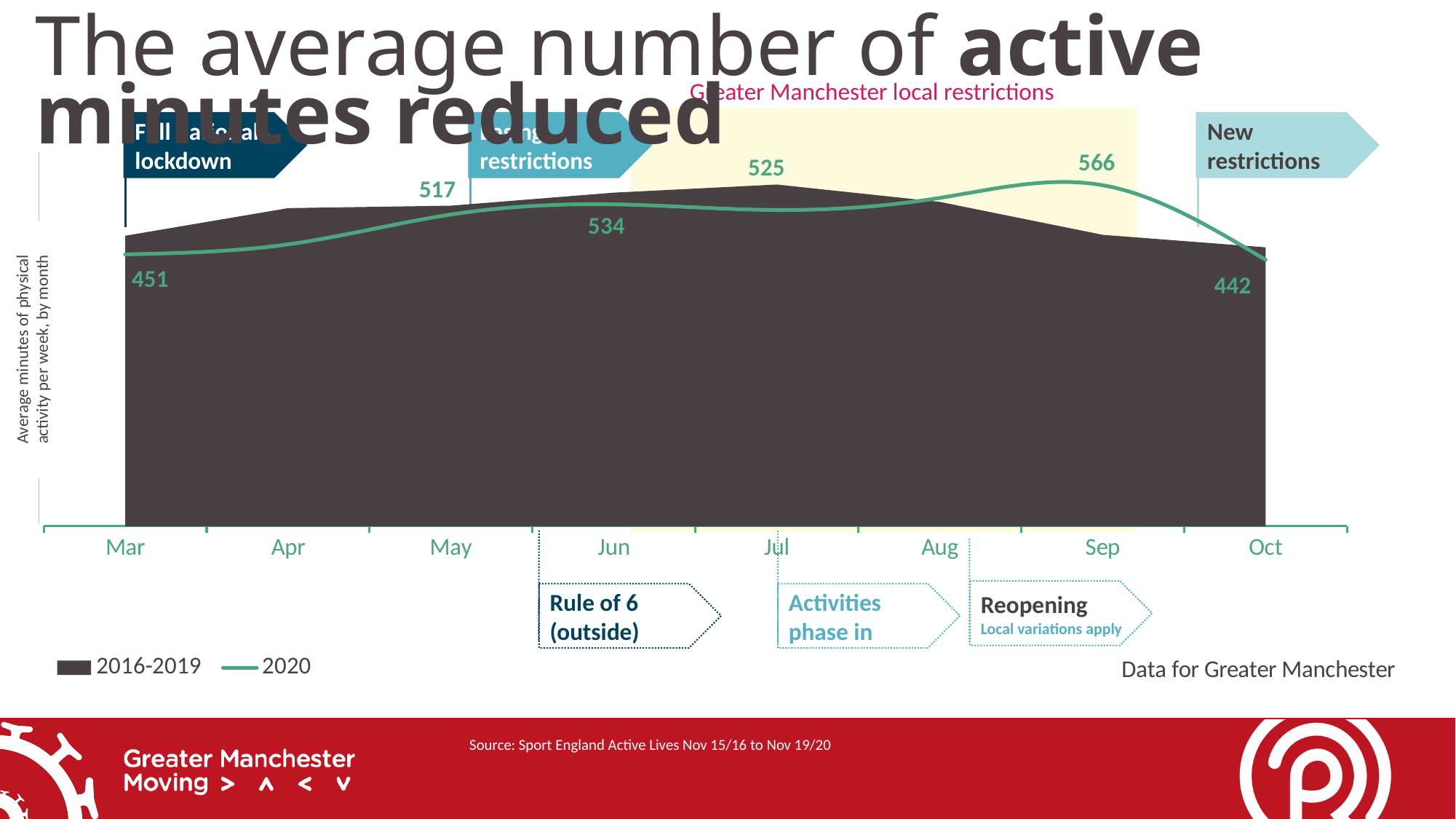
Which month has the highest labelled 2020 value? Sep What is the 2020 value for Jul? 525 How many series does the legend list? 2 What is the 2020 value for Mar? 451 What is the 2020 value for Sep? 566 Which month has the lowest labelled 2020 value? Oct Does the 2020 line rise or fall between Sep and Oct? fall What is the difference between the 2020 values for Sep and Oct? 124 How many months are shown on the x axis? 8 What is the 2020 value for Jun? 534 What is the 2020 value for Oct? 442 Which is larger, the 2020 value for Jun or for Jul? Jun